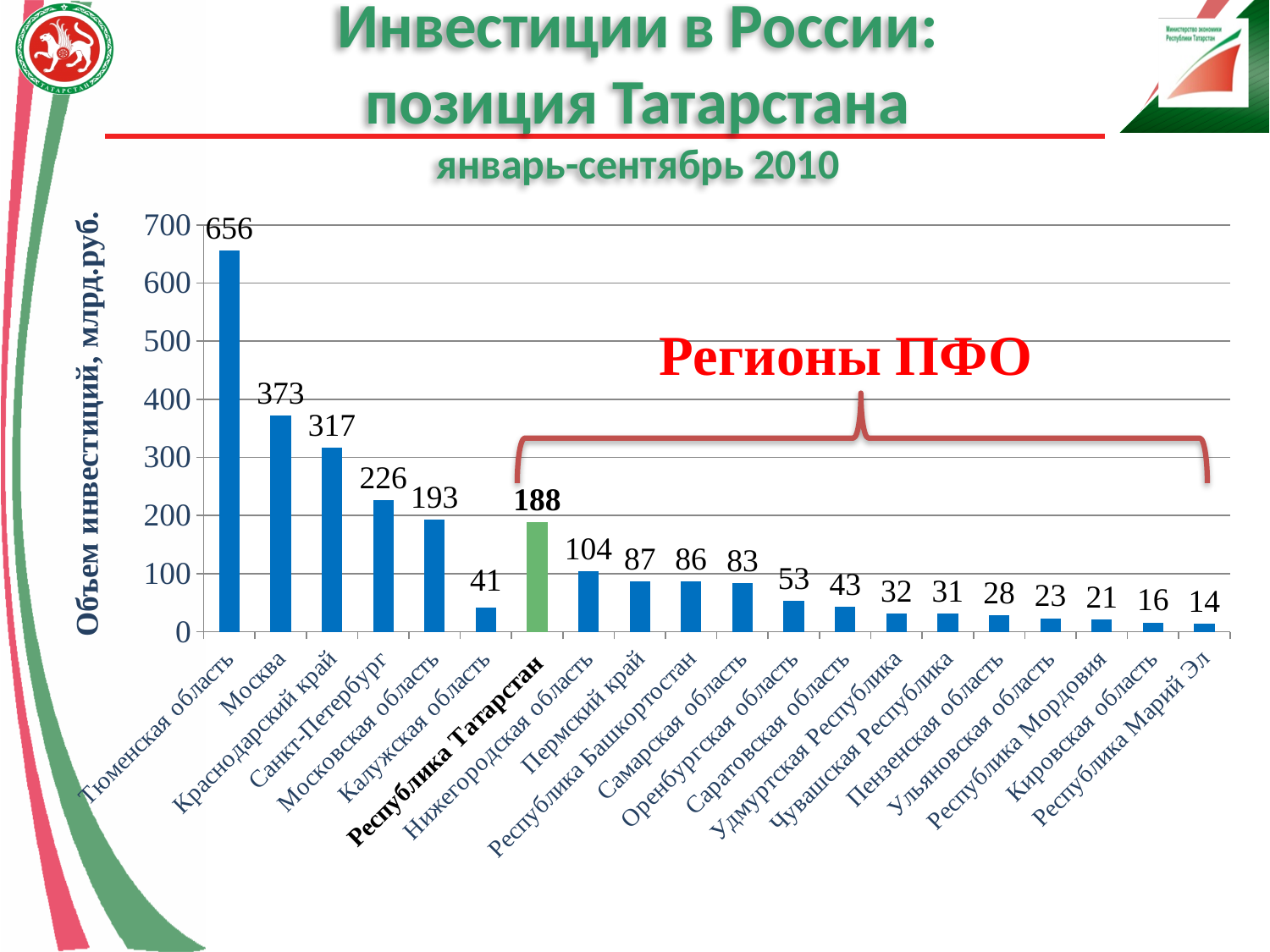
What is the difference between the values for Республика Татарстан and Нижегородская область? 84 What is the difference between the values for Тюменская область and Москва? 283 What is the value for Республика Татарстан? 188 Which region has the lowest value? Республика Марий Эл How many regions are shown on the chart? 20 Is the value for Санкт-Петербург greater or less than 200? greater What is the label of the vertical axis? Объем инвестиций, млрд.руб. What is the value for Москва? 373 Which region has the highest value? Тюменская область Which is larger, the value for Калужская область or the value for Республика Татарстан? Республика Татарстан What is the value for Нижегородская область? 104 What kind of chart is shown on the slide? bar chart